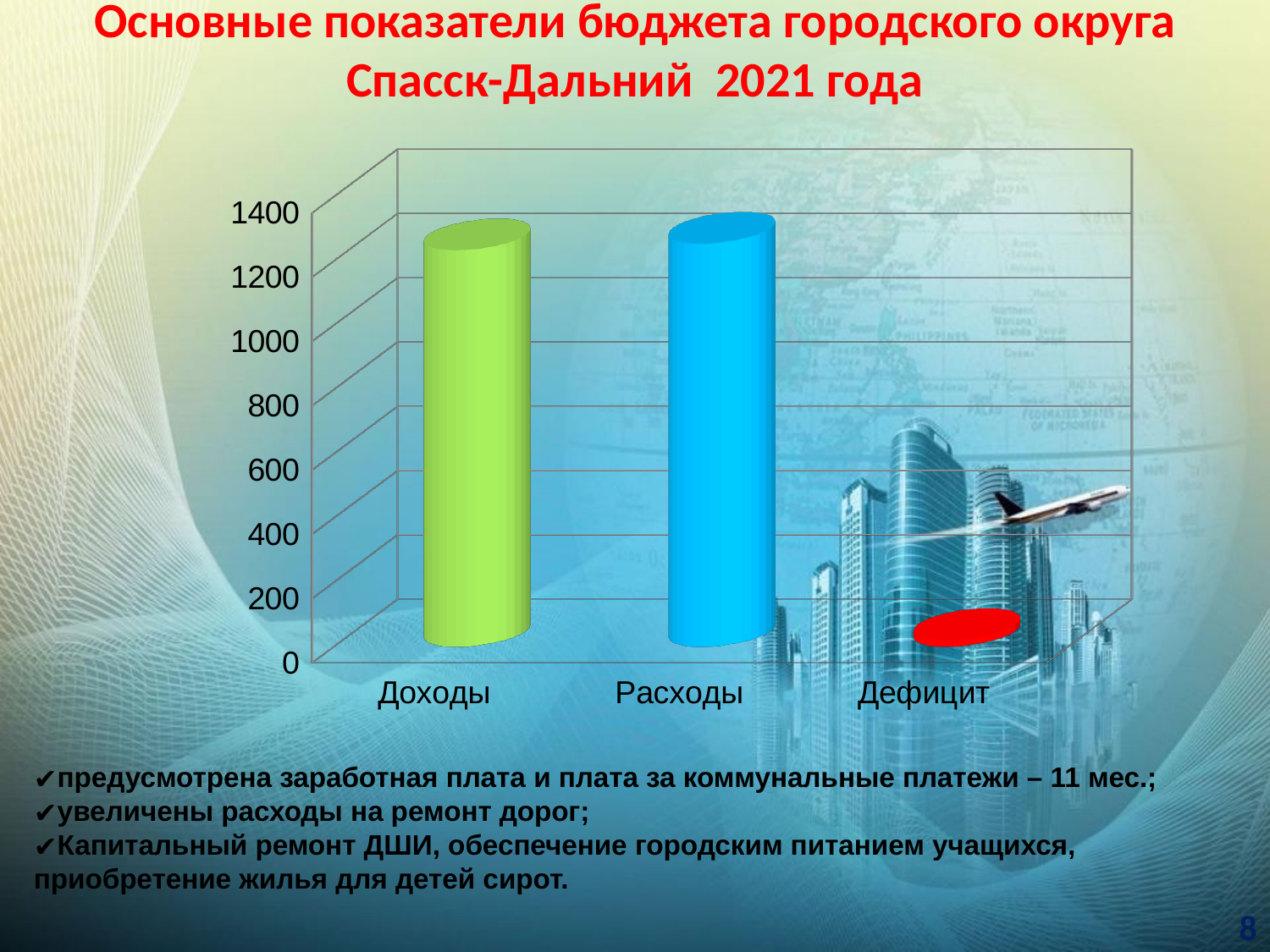
How many categories are shown on the x axis of the chart? 3 What colour is the bar for Расходы? blue Is the value for Расходы greater or less than 1200? greater Is the value for Дефицит greater or less than 200? less Which is larger, the value for Расходы or the value for Дефицит? Расходы Which is larger, the value for Доходы or the value for Дефицит? Доходы What kind of chart is shown on the slide? bar chart Which category has the lowest value in the chart? Дефицит Is the value for Доходы greater or less than 1000? greater What is the highest tick value shown on the vertical axis of the chart? 1400